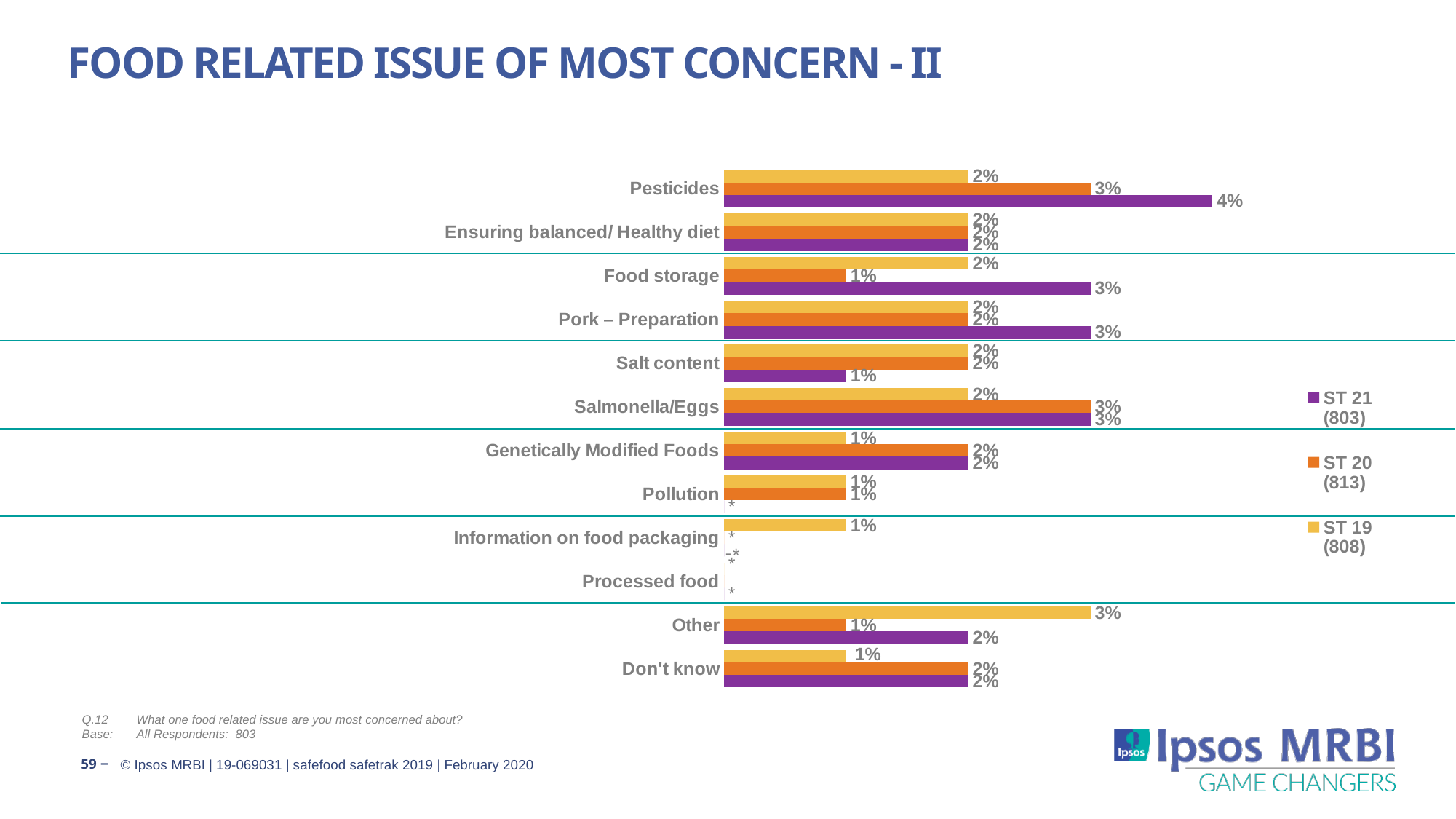
What is the difference between the ST 21 (803) and ST 19 (808) values for Pesticides? 2% Which category has the highest ST 19 (808) value? Other What is the ST 19 (808) value for Other? 3% Which category has the highest ST 21 (803) value? Pesticides How many categories are shown on the chart? 12 What kind of chart is shown on the slide? Bar chart How many series does the legend list? 3 What is the ST 19 (808) value for Genetically Modified Foods? 1% For Food storage, which is larger: the ST 21 (803) value or the ST 20 (813) value? ST 21 (803) What is the ST 21 (803) value for Pesticides? 4% What is the ST 20 (813) value for Food storage? 1% What is the ST 21 (803) value for Salt content? 1%